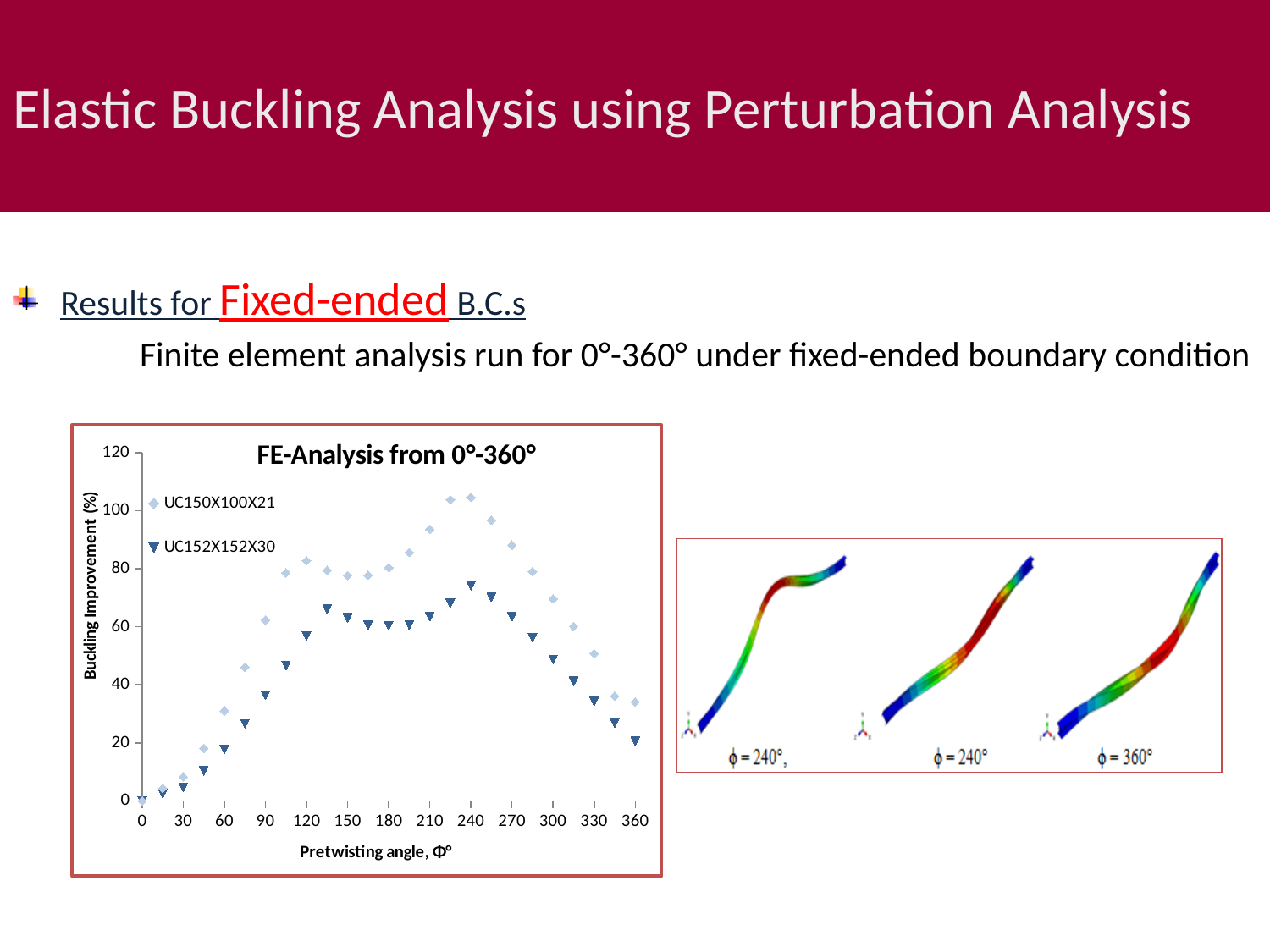
At a pretwisting angle of 240, which series has the higher buckling improvement, UC150X100X21 or UC152X152X30? UC150X100X21 At a pretwisting angle of 180, which series has the lower buckling improvement, UC150X100X21 or UC152X152X30? UC152X152X30 What kind of chart is shown on the slide? Scatter chart Between pretwisting angles of 240 and 360, do the values for UC150X100X21 rise or fall? fall Is the value for UC150X100X21 at a pretwisting angle of 240 greater or less than 80? greater At which pretwisting angle does the UC152X152X30 series reach its highest buckling improvement? 240 What is the label of the y axis of the chart? Buckling Improvement (%) Is the value for UC152X152X30 at a pretwisting angle of 240 greater or less than 80? less How many series does the legend of the chart list? 2 Is the value for UC152X152X30 at a pretwisting angle of 90 greater or less than 60? less What is the title of the chart? FE-Analysis from 0°-360°